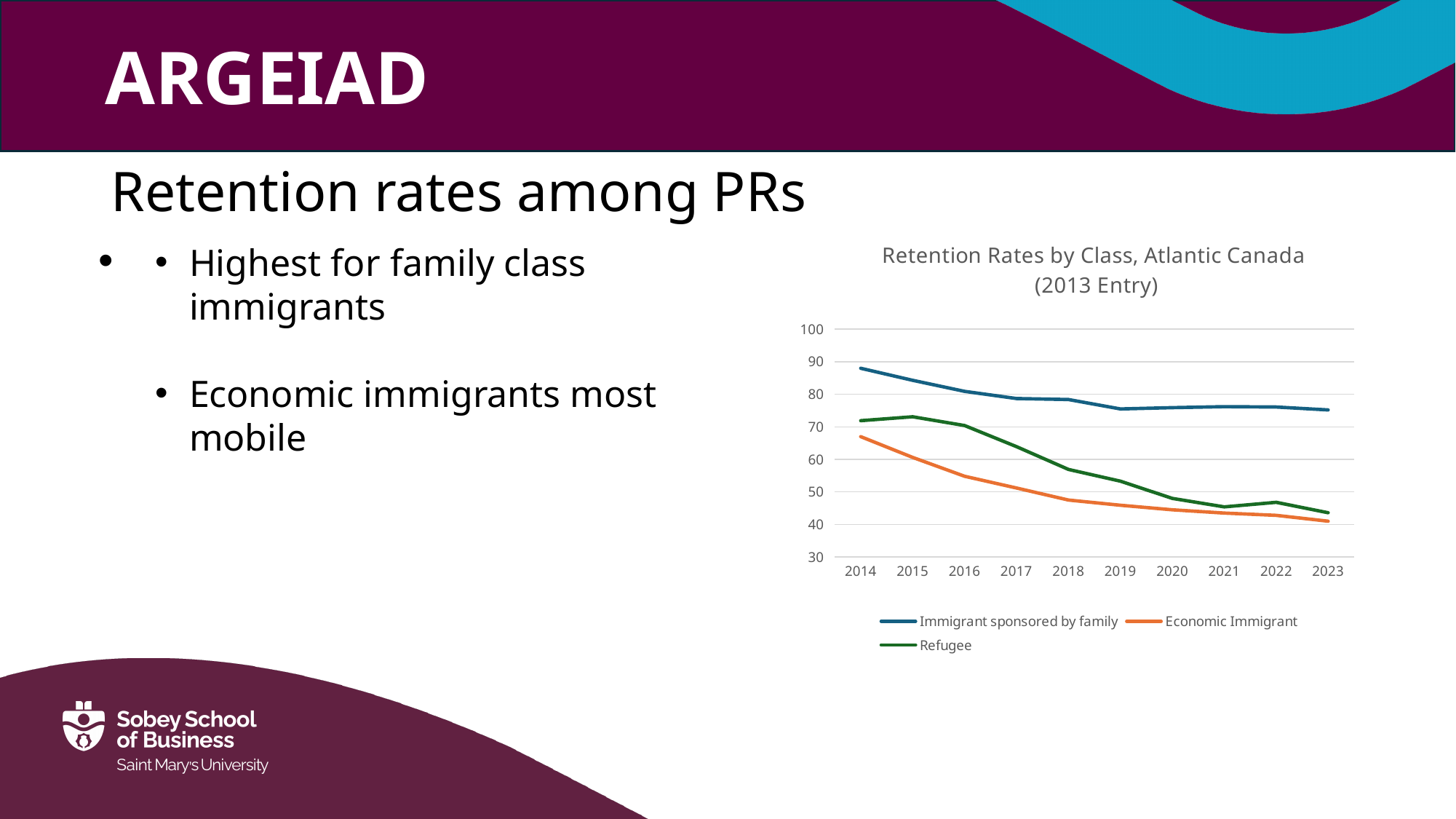
Is the value for Immigrant sponsored by family in 2014 greater or less than 80? greater In 2019, which is larger: the Refugee value or the Economic Immigrant value? Refugee Which series has the lowest retention rate in 2023? Economic Immigrant How many years are shown along the x axis of the chart? 10 What is the title of the chart? Retention Rates by Class, Atlantic Canada (2013 Entry) Do the retention rates for Economic Immigrant rise or fall from 2014 to 2023? fall Is the value for Refugee in 2014 greater or less than 60? greater Is the value for Economic Immigrant in 2023 greater or less than 50? less Which series has the highest retention rate in 2023? Immigrant sponsored by family How many series does the chart's legend list? 3 What kind of chart is shown on the slide? line chart